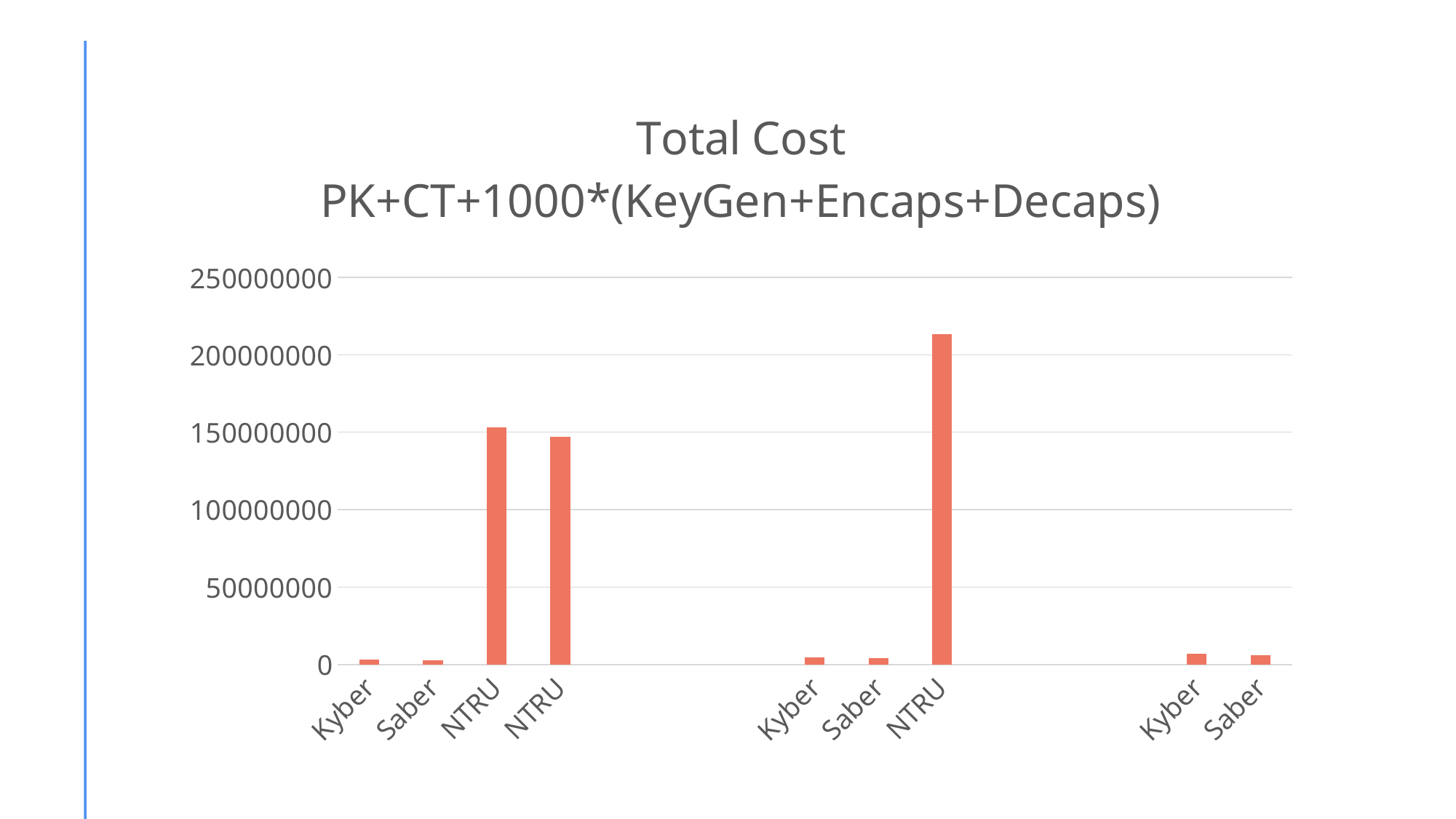
Which is larger, the third bar from the left (NTRU) or the fourth bar from the left (NTRU)? the third bar from the left (NTRU) Which is larger, the NTRU bar in the middle group or the first NTRU bar in the left group? the NTRU bar in the middle group How many bars are plotted in the chart? 9 Is the value of the leftmost Kyber bar greater or less than 50000000? less Is the value of the second NTRU bar (fourth bar from the left) greater or less than 150000000? less Is the value of the tallest NTRU bar (in the middle group) greater or less than 200000000? greater What kind of chart is shown on the slide? bar chart Which bar is the tallest in the chart? the NTRU bar in the middle group What is the title of the chart? Total Cost PK+CT+1000*(KeyGen+Encaps+Decaps) What is the highest value shown on the vertical axis? 250000000